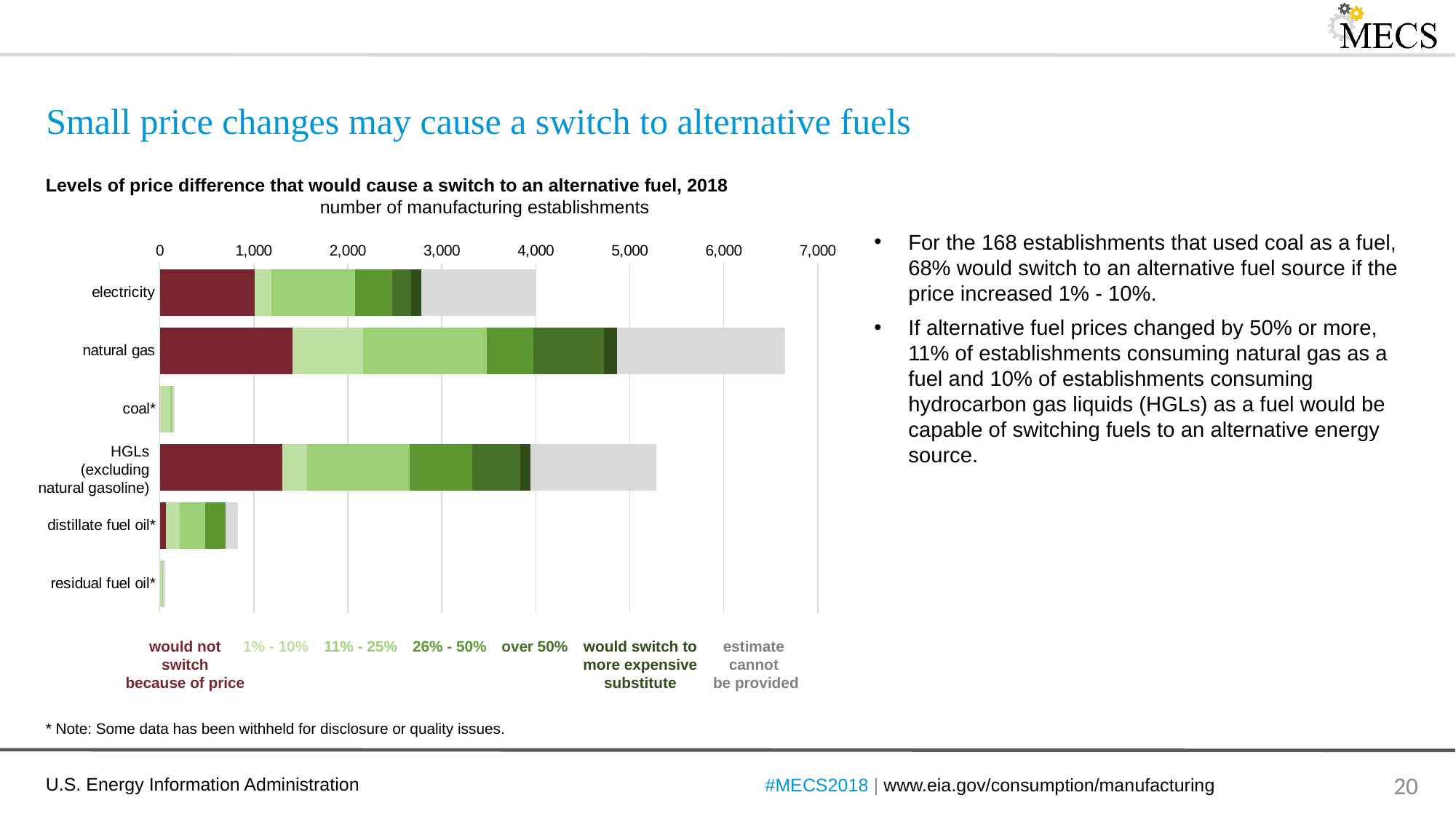
How many fuel categories are plotted on the chart? 6 Which fuel category has the longest total bar? natural gas What kind of chart is shown on the slide? bar chart Is the 'would not switch because of price' segment for natural gas greater or less than 1,000? greater Is the total bar for natural gas greater or less than 6,000? greater Which has a longer total bar, electricity or HGLs (excluding natural gasoline)? HGLs (excluding natural gasoline) Which fuel category has the shortest total bar? residual fuel oil* What unit is the horizontal axis measured in, according to the chart subtitle? number of manufacturing establishments Is the total bar for distillate fuel oil* greater or less than 1,000? less How many series does the chart legend list? 7 What is the title of the chart? Levels of price difference that would cause a switch to an alternative fuel, 2018